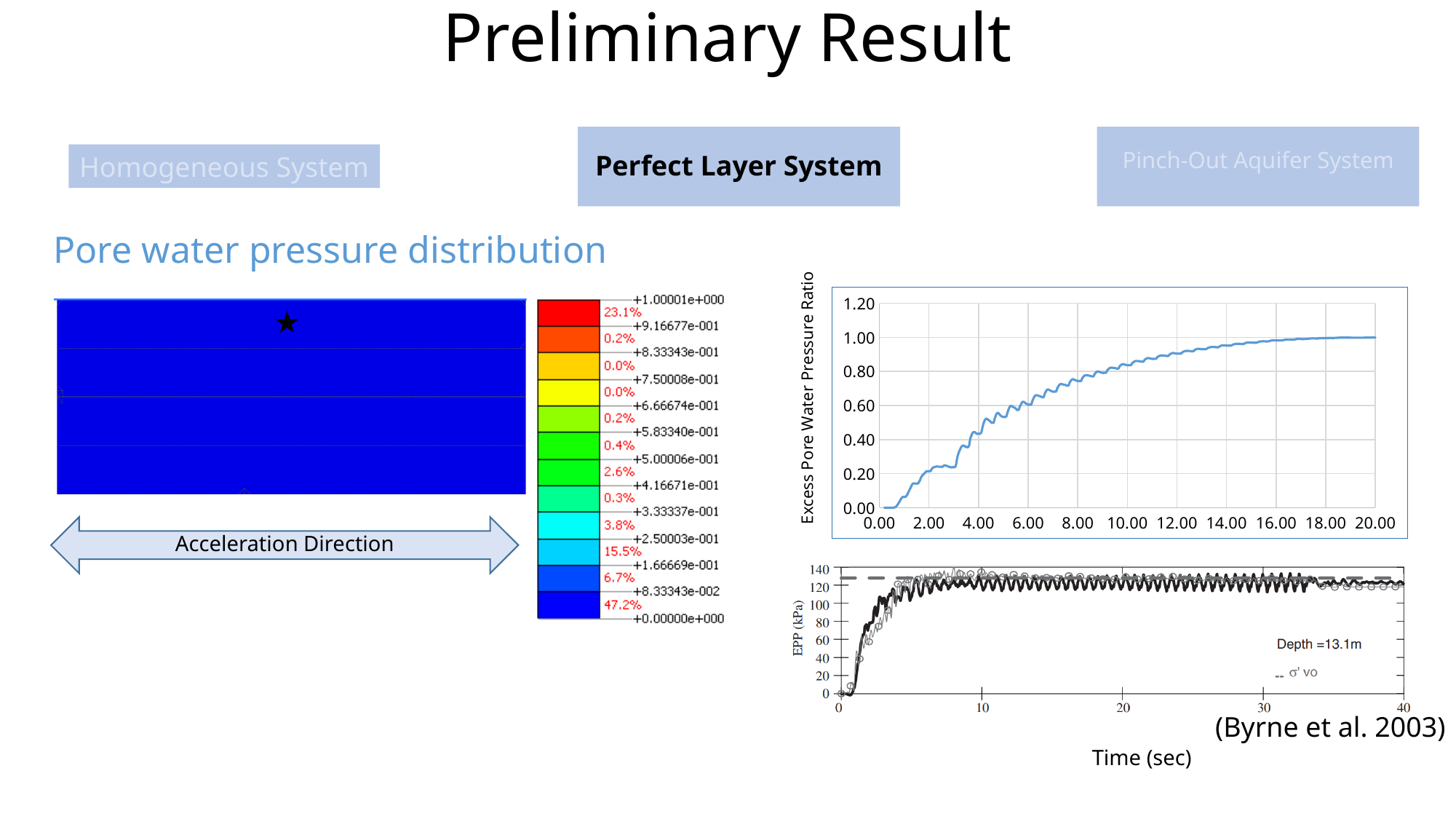
In the lower right chart (EPP vs Time), is the EPP value at time 20 greater or less than 100 kPa? greater What is the largest value shown on the x axis of the lower right chart (EPP vs Time)? 40 In the lower right chart (EPP vs Time), is the EPP value at time 1 greater or less than 60 kPa? less In the upper right chart, is the Excess Pore Water Pressure Ratio at time 10.00 greater or less than 0.60? greater What kind of chart is the upper right chart of Excess Pore Water Pressure Ratio against time? line chart What depth is annotated on the lower right chart (EPP vs Time)? 13.1m What is the y-axis label of the upper right chart? Excess Pore Water Pressure Ratio What is the largest value shown on the x axis of the upper right chart? 20.00 In the upper right chart, does the Excess Pore Water Pressure Ratio rise or fall as time increases from 0.00 to 20.00? rise